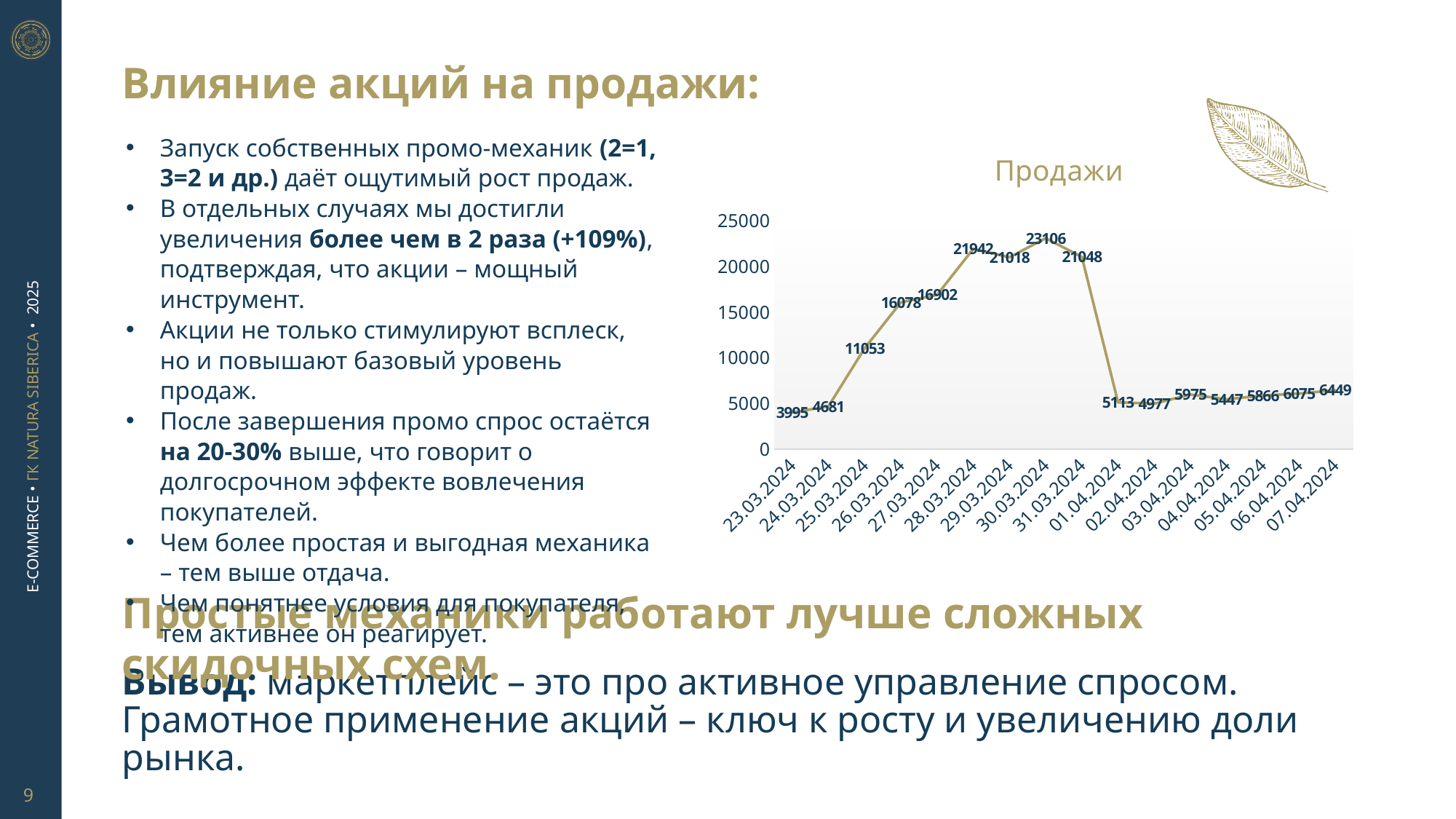
What is the value for 23.03.2024? 3995 What type of chart is shown on the slide? line chart What is the value for 30.03.2024? 23106 Is the value for 01.04.2024 greater or less than 10000? less Which is larger, the value for 28.03.2024 or the value for 29.03.2024? 28.03.2024 What is the title of the chart? Продажи What is the value for 07.04.2024? 6449 What is the difference between the values for 30.03.2024 and 23.03.2024? 19111 What is the value for 25.03.2024? 11053 How many data points are plotted on the chart? 16 On which date is the value highest? 30.03.2024 On which date is the value lowest? 23.03.2024